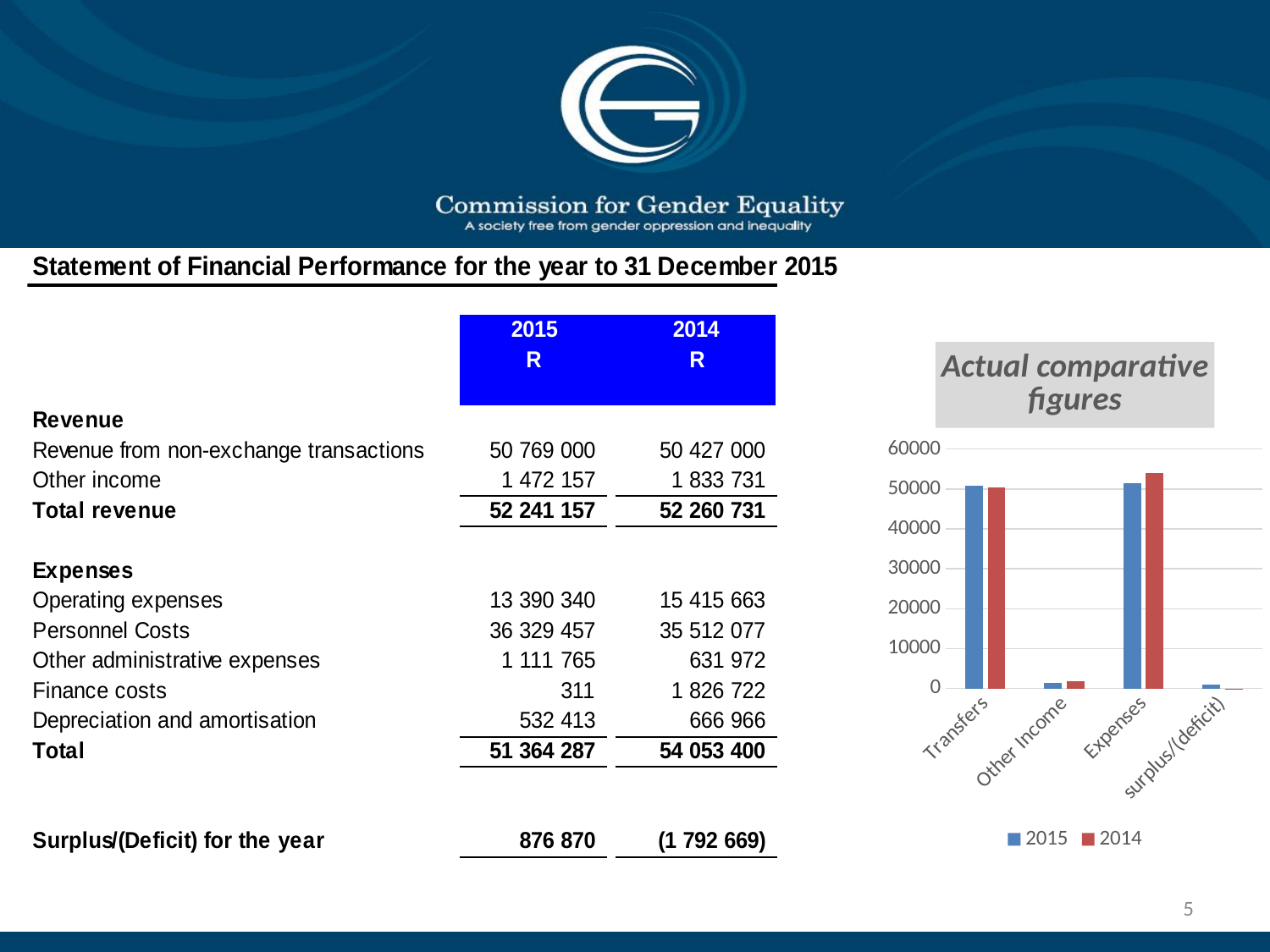
Is the 2015 value for Transfers greater or less than 40000? greater Which series is shown in red in the chart? 2014 How many categories are shown on the x axis of the chart? 4 What is the title of the chart on the slide? Actual comparative figures What kind of chart is shown on the slide? bar chart Is the 2015 value for Surplus/(deficit) greater or less than 10000? less How many series does the chart's legend list? 2 Is the 2015 value for Other Income greater or less than 10000? less Which category has the tallest bar in the chart? Expenses Which category has the lowest 2014 bar in the chart? Surplus/(deficit) For Expenses, which year has the larger bar, 2015 or 2014? 2014